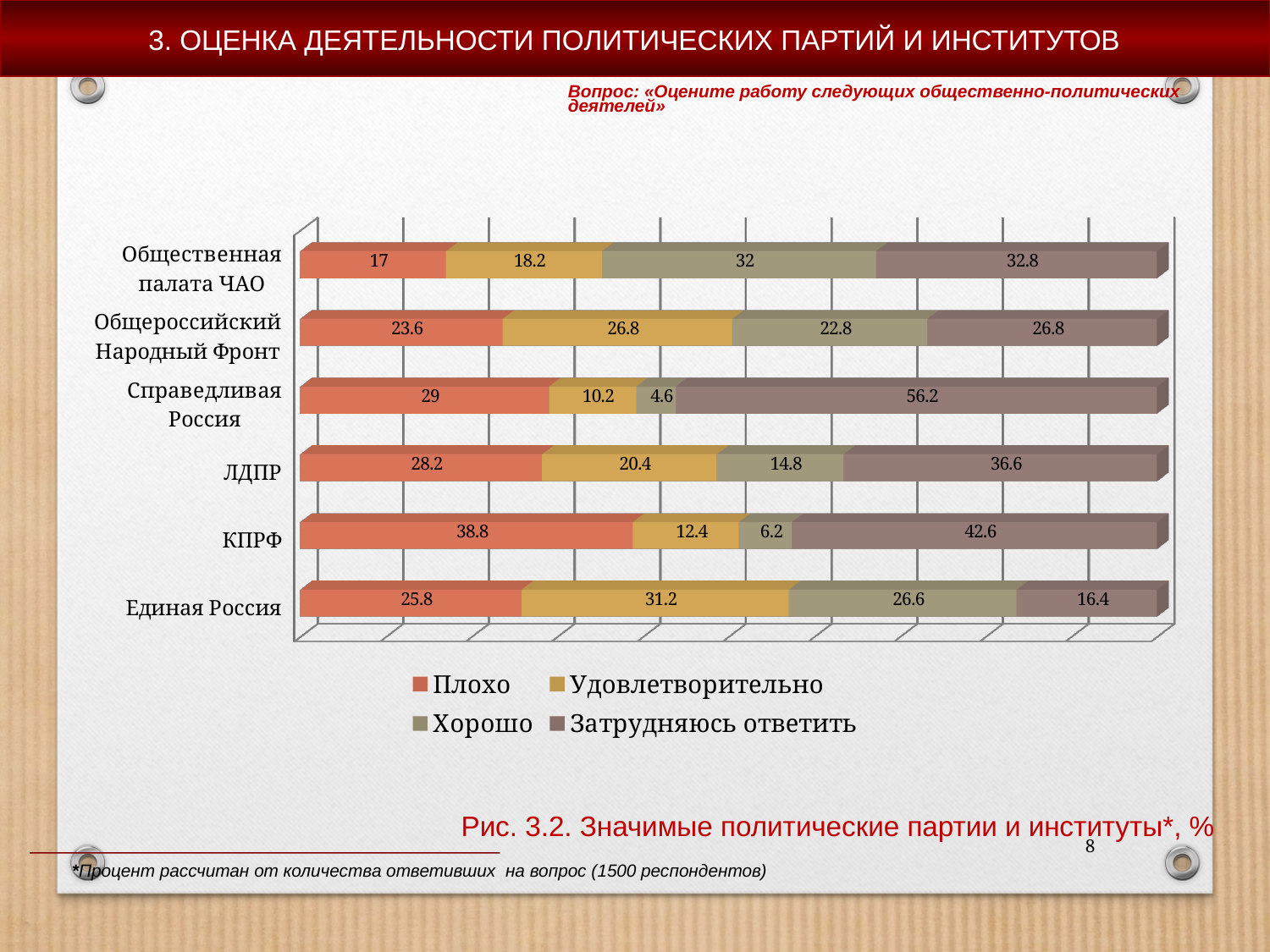
What is the total of the stacked bar for ЛДПР? 100 What is the value of the "Затрудняюсь ответить" series for Справедливая Россия? 56.2 What is the difference between the "Удовлетворительно" values for Единая Россия and ЛДПР? 10.8 What is the value of the "Плохо" series for КПРФ? 38.8 Which has the larger "Затрудняюсь ответить" value: ЛДПР or Общероссийский Народный Фронт? ЛДПР Which category has the highest value in the "Плохо" series? КПРФ How many categories (parties and institutions) are shown on the chart? 6 What kind of chart is shown on the slide? Stacked bar chart What is the value of the "Хорошо" series for Единая Россия? 26.6 How many series does the legend list? 4 Which category has the lowest value in the "Хорошо" series? Справедливая Россия Which legend entry is shown in the darkest (brownish-grey) colour? Затрудняюсь ответить